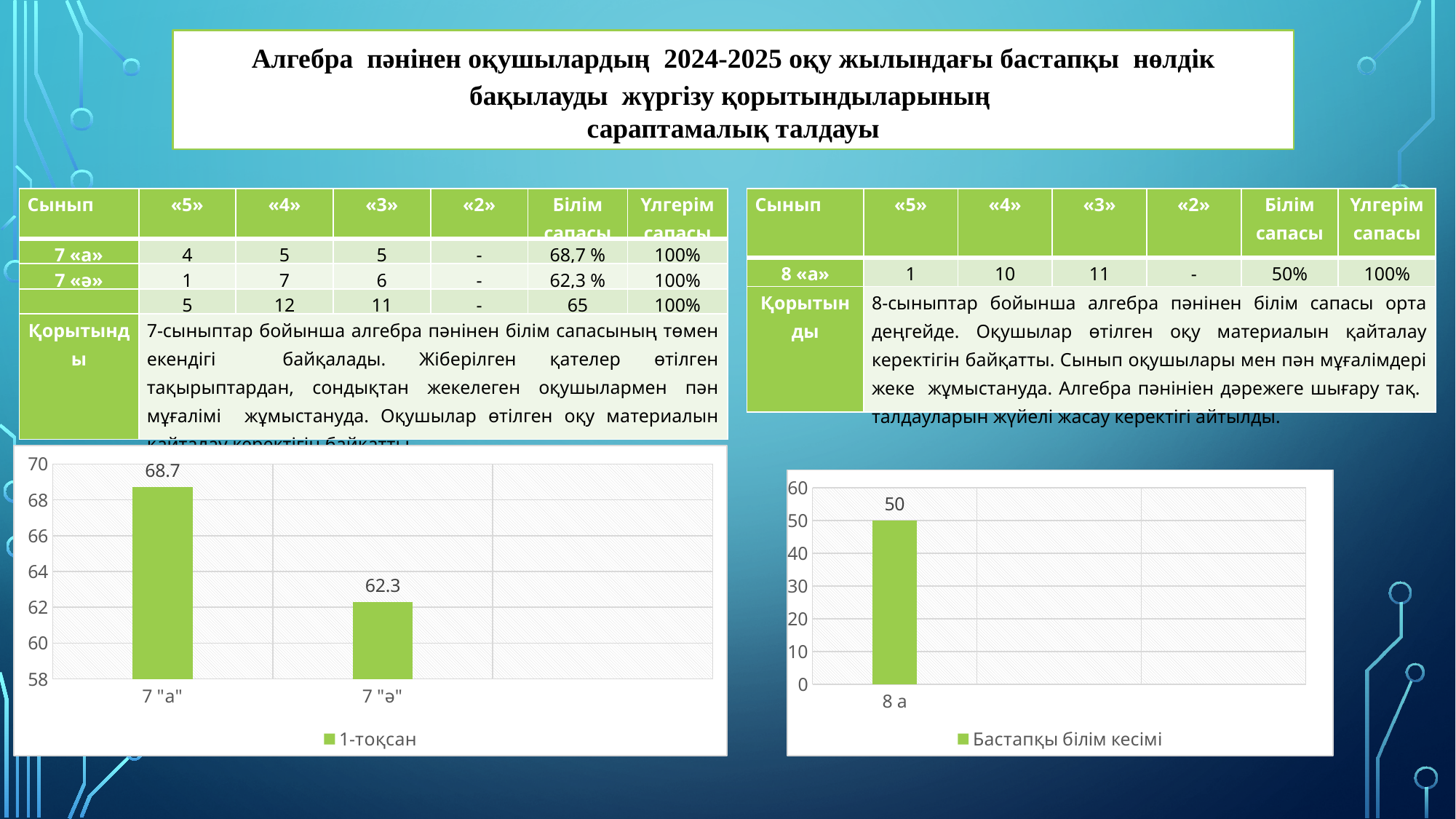
In the right chart, how many bars are plotted? 1 In the left chart, what is the value for 7 "а"? 68.7 In the right chart, what is the value for 8 а? 50 In the left chart, which category has the highest value? 7 "а" In the left chart, what is the difference between the values for 7 "а" and 7 "ә"? 6.4 What kind of chart is the right chart? bar chart In the left chart, which category has the lowest value? 7 "ә" In the right chart, what series name does the legend show? Бастапқы білім кесімі In the left chart, what is the value for 7 "ә"? 62.3 In the left chart, how many categories are shown on the x axis? 2 In the left chart, what series name does the legend show? 1-тоқсан In the left chart, which is larger: the value for 7 "а" or 7 "ә"? 7 "а"